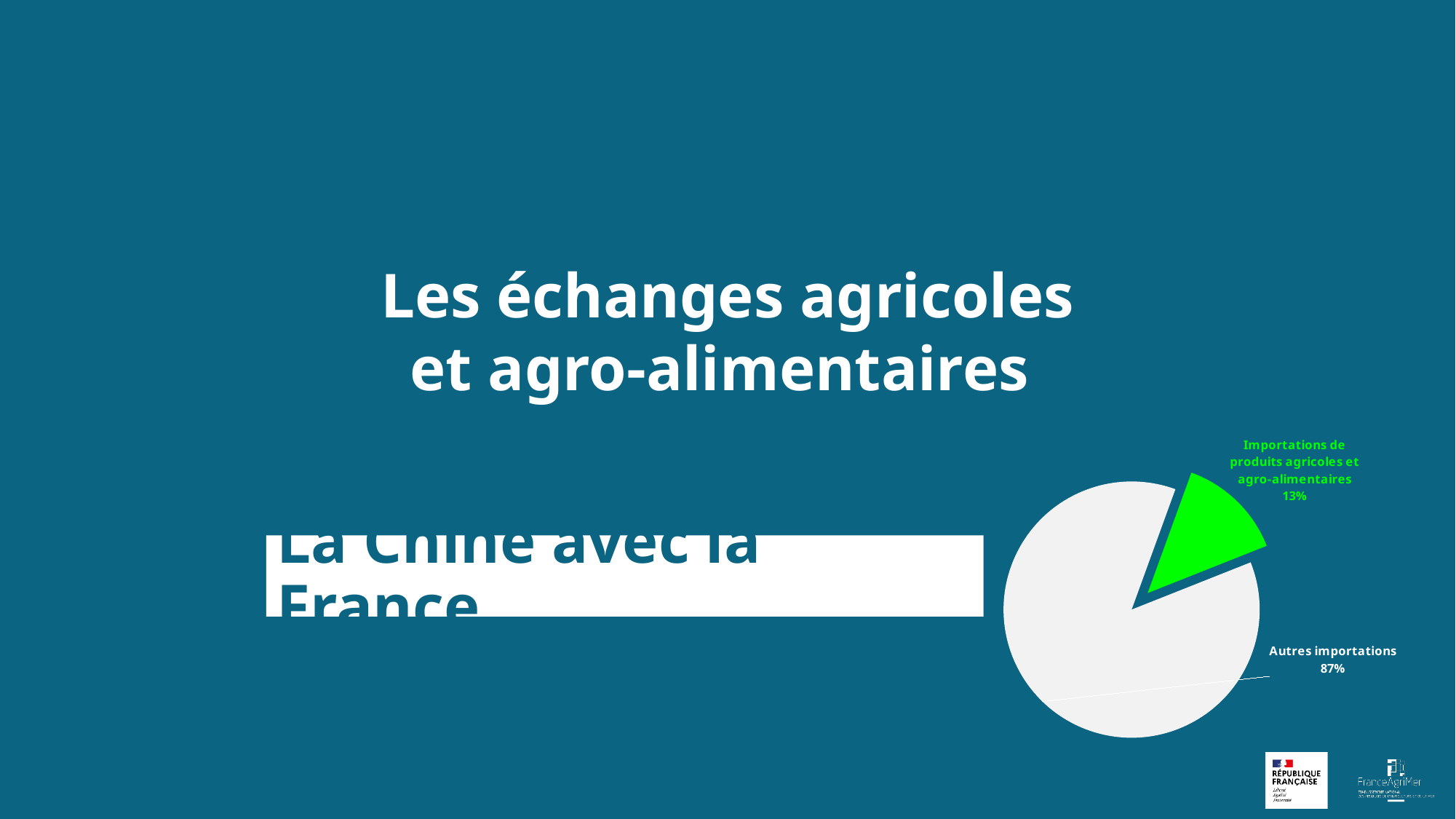
What is the difference in percentage points between 'Autres importations' and 'Importations de produits agricoles et agro-alimentaires'? 74 percentage points What kind of chart is shown on the slide? pie chart Which slice of the pie is the largest? Autres importations Which slice of the pie is the smallest? Importations de produits agricoles et agro-alimentaires What colour is the slice for 'Importations de produits agricoles et agro-alimentaires'? green What colour is the slice for 'Autres importations'? light grey What share of the pie is 'Autres importations'? 87% What share of the pie is 'Importations de produits agricoles et agro-alimentaires'? 13% How many slices does the pie chart have? 2 Which is larger: 'Autres importations' or 'Importations de produits agricoles et agro-alimentaires'? Autres importations